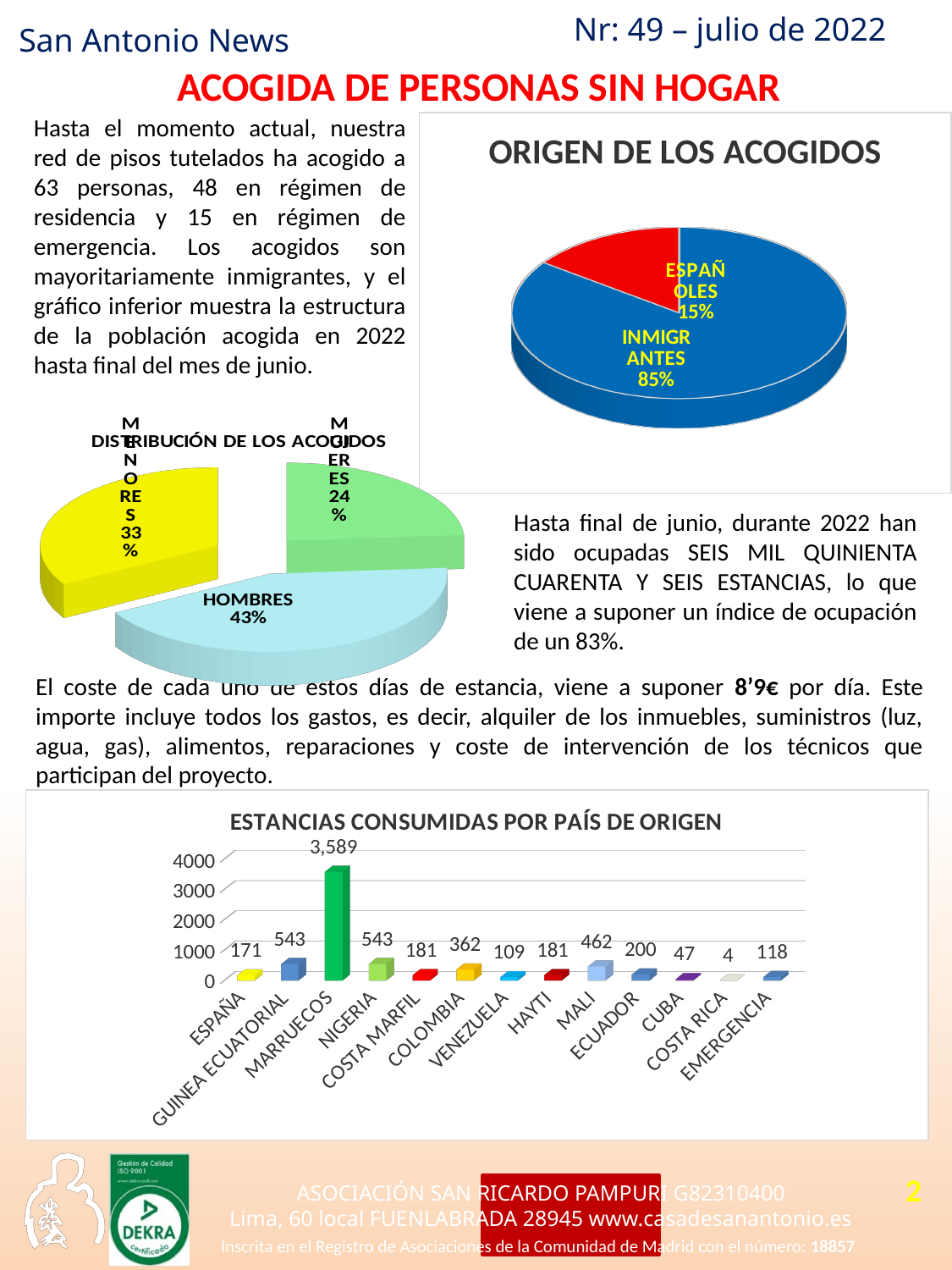
In the 'ESTANCIAS CONSUMIDAS POR PAÍS DE ORIGEN' chart, what is the difference between MALI and ECUADOR? 262 In the 'ESTANCIAS CONSUMIDAS POR PAÍS DE ORIGEN' chart, which is larger, COLOMBIA or VENEZUELA? COLOMBIA In the 'ORIGEN DE LOS ACOGIDOS' chart, what share is shown for INMIGRANTES? 85% What kind of chart is 'ESTANCIAS CONSUMIDAS POR PAÍS DE ORIGEN'? Bar chart In the 'ESTANCIAS CONSUMIDAS POR PAÍS DE ORIGEN' chart, what is the value for MARRUECOS? 3,589 In the 'DISTRIBUCIÓN DE LOS ACOGIDOS' chart, what share is shown for HOMBRES? 43% How many countries/categories are shown in the 'ESTANCIAS CONSUMIDAS POR PAÍS DE ORIGEN' chart? 13 In the 'DISTRIBUCIÓN DE LOS ACOGIDOS' chart, which group has the smallest share? MUJERES In the 'ORIGEN DE LOS ACOGIDOS' chart, what share is shown for ESPAÑOLES? 15% What kind of chart is 'ORIGEN DE LOS ACOGIDOS'? Pie chart In the 'DISTRIBUCIÓN DE LOS ACOGIDOS' chart, how many slices are there? 3 In the 'ESTANCIAS CONSUMIDAS POR PAÍS DE ORIGEN' chart, which country has the lowest value? COSTA RICA